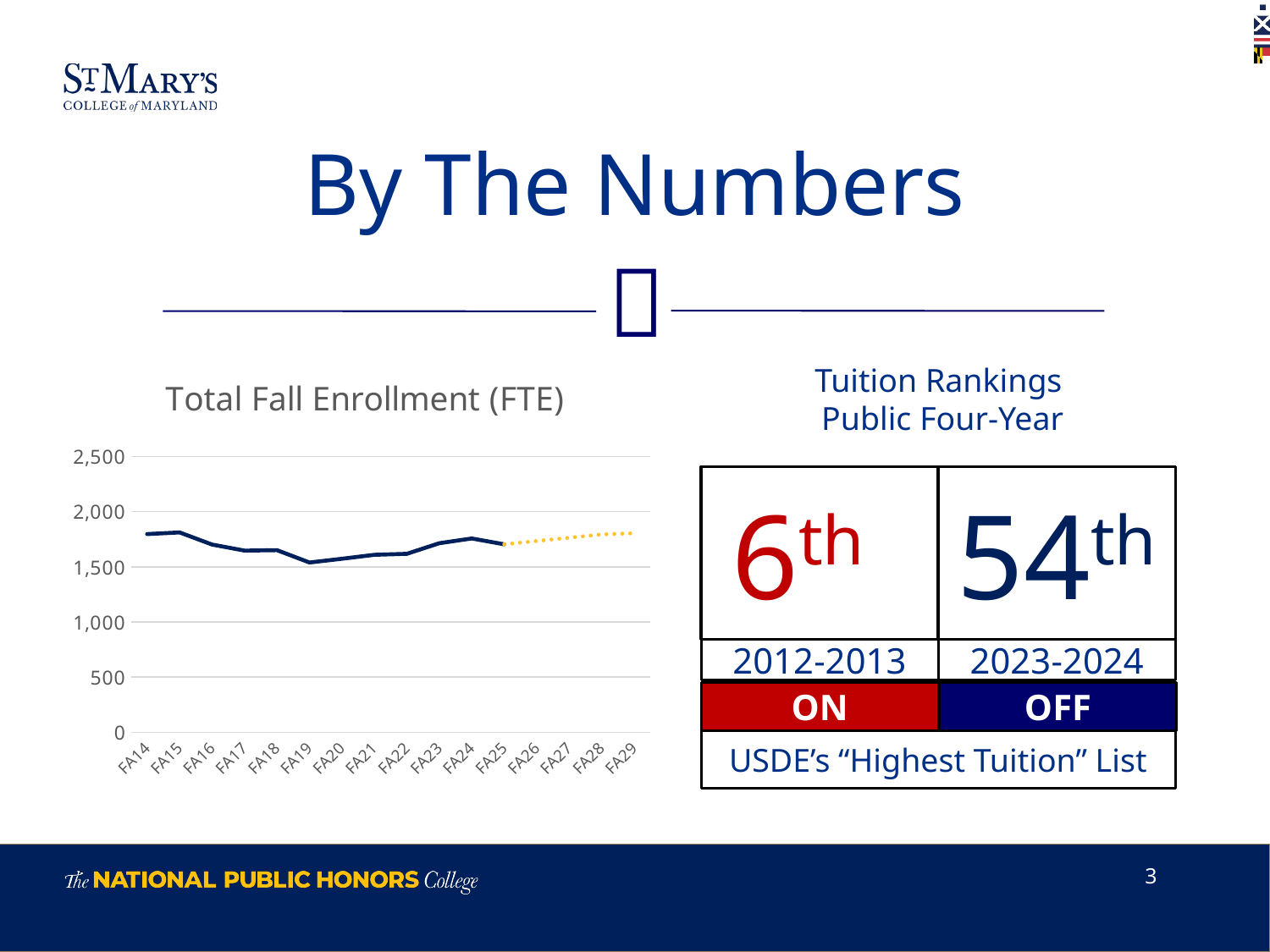
Does Total Fall Enrollment (FTE) rise or fall from FA14 to FA19? fall Does Total Fall Enrollment (FTE) rise or fall from FA19 to FA24? rise Is the Total Fall Enrollment (FTE) value for FA19 greater or less than 2,000? less Is the Total Fall Enrollment (FTE) value for FA14 greater or less than 1,500? greater Which term has the lowest Total Fall Enrollment (FTE) on the chart? FA19 Which has the larger Total Fall Enrollment (FTE), FA14 or FA19? FA14 Is the Total Fall Enrollment (FTE) value for FA25 greater or less than 1,000? greater How many fall terms are shown on the x axis of the Total Fall Enrollment (FTE) chart? 16 Which has the larger Total Fall Enrollment (FTE), FA22 or FA24? FA24 What kind of chart is used to show Total Fall Enrollment (FTE)? line chart What is the first term shown on the x axis of the Total Fall Enrollment (FTE) chart? FA14 What is the title of the chart on the slide? Total Fall Enrollment (FTE)